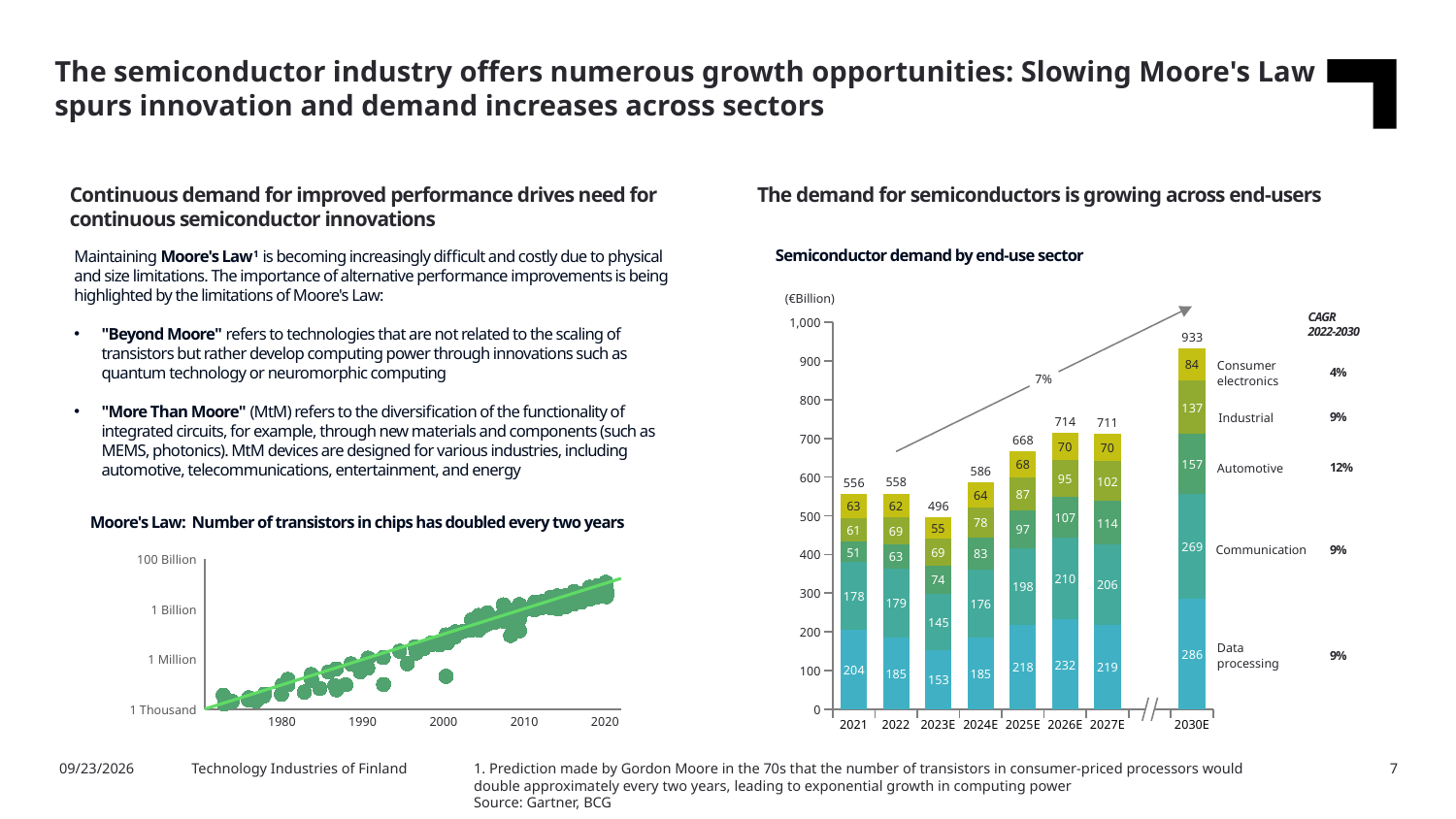
In the 'Semiconductor demand by end-use sector' chart, what is the Communication value for 2030E? 269 How many end-use sectors are shown as series in the 'Semiconductor demand by end-use sector' chart? 5 In the 'Semiconductor demand by end-use sector' chart, which year has the lowest total demand? 2023E What kind of chart is the 'Semiconductor demand by end-use sector' chart on the right? Stacked bar chart In the 'Semiconductor demand by end-use sector' chart, which year has the highest total demand? 2030E In the 'Semiconductor demand by end-use sector' chart, which year has the larger total: 2026E or 2027E? 2026E In the 'Semiconductor demand by end-use sector' chart, what is the CAGR 2022-2030 shown for Automotive? 12% In the 'Semiconductor demand by end-use sector' chart, what is the total semiconductor demand shown for 2030E? 933 In the 'Moore's Law' chart on the left, do the values rise or fall over time along the x axis? Rise How many years (bars) are shown in the 'Semiconductor demand by end-use sector' chart? 8 In the 'Semiconductor demand by end-use sector' chart, what is the Data processing value for 2021? 204 In the 'Semiconductor demand by end-use sector' chart, what is the difference between the total for 2030E and the total for 2021? 377